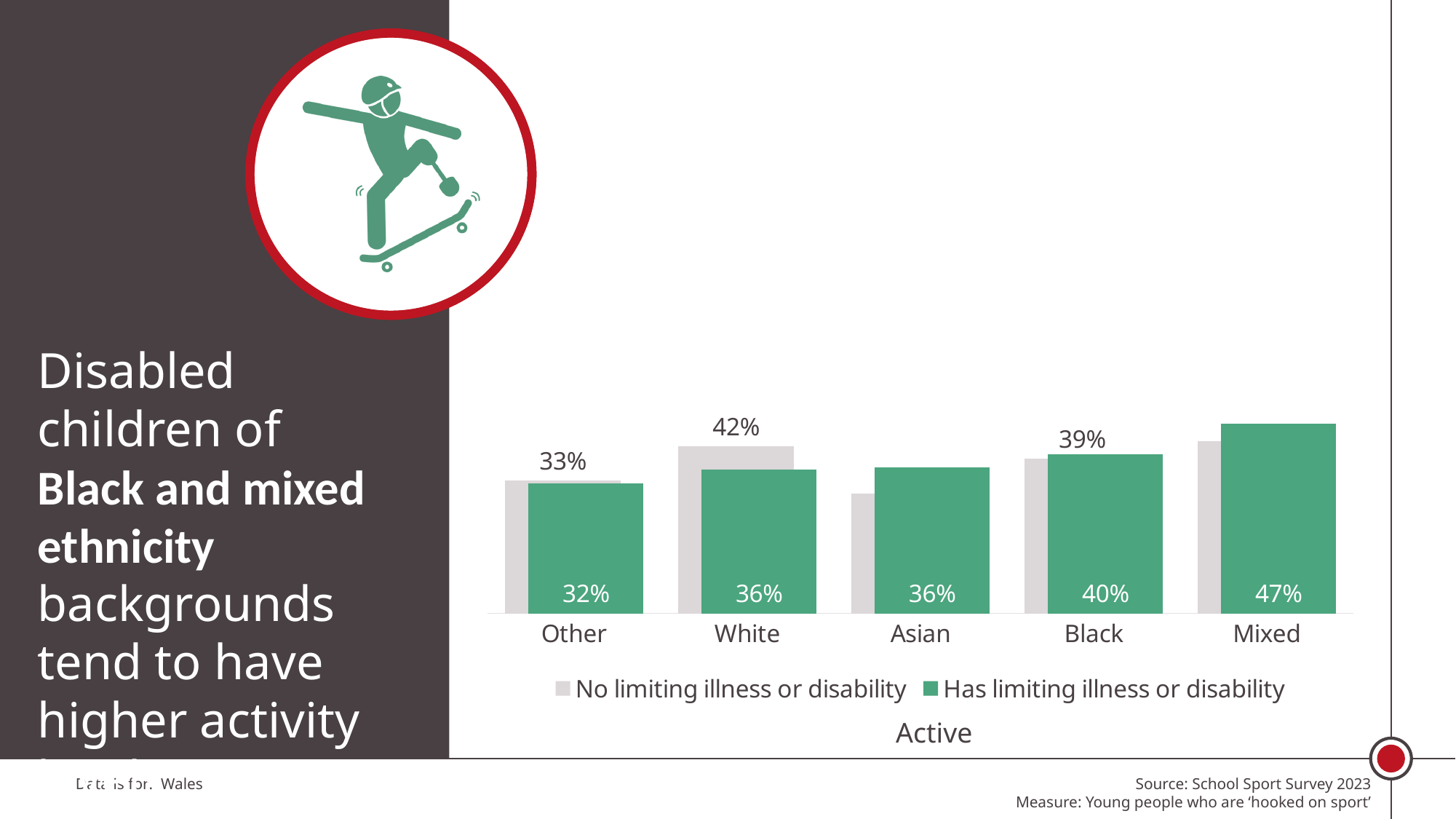
What is the value for White in the 'No limiting illness or disability' series? 42% Which colour represents the 'Has limiting illness or disability' series? Green How many ethnicity categories are shown on the x axis? 5 What is the difference between the 'No limiting illness or disability' and 'Has limiting illness or disability' values for White? 6% What kind of chart is shown on the slide? Bar chart How many series does the legend list? 2 For Black, which is larger: the 'No limiting illness or disability' value or the 'Has limiting illness or disability' value? Has limiting illness or disability What is the value for Mixed in the 'Has limiting illness or disability' series? 47% What is the value for Other in the 'No limiting illness or disability' series? 33% Which category has the lowest value in the 'Has limiting illness or disability' series? Other What is the value for Black in the 'Has limiting illness or disability' series? 40% Which category has the highest value in the 'Has limiting illness or disability' series? Mixed